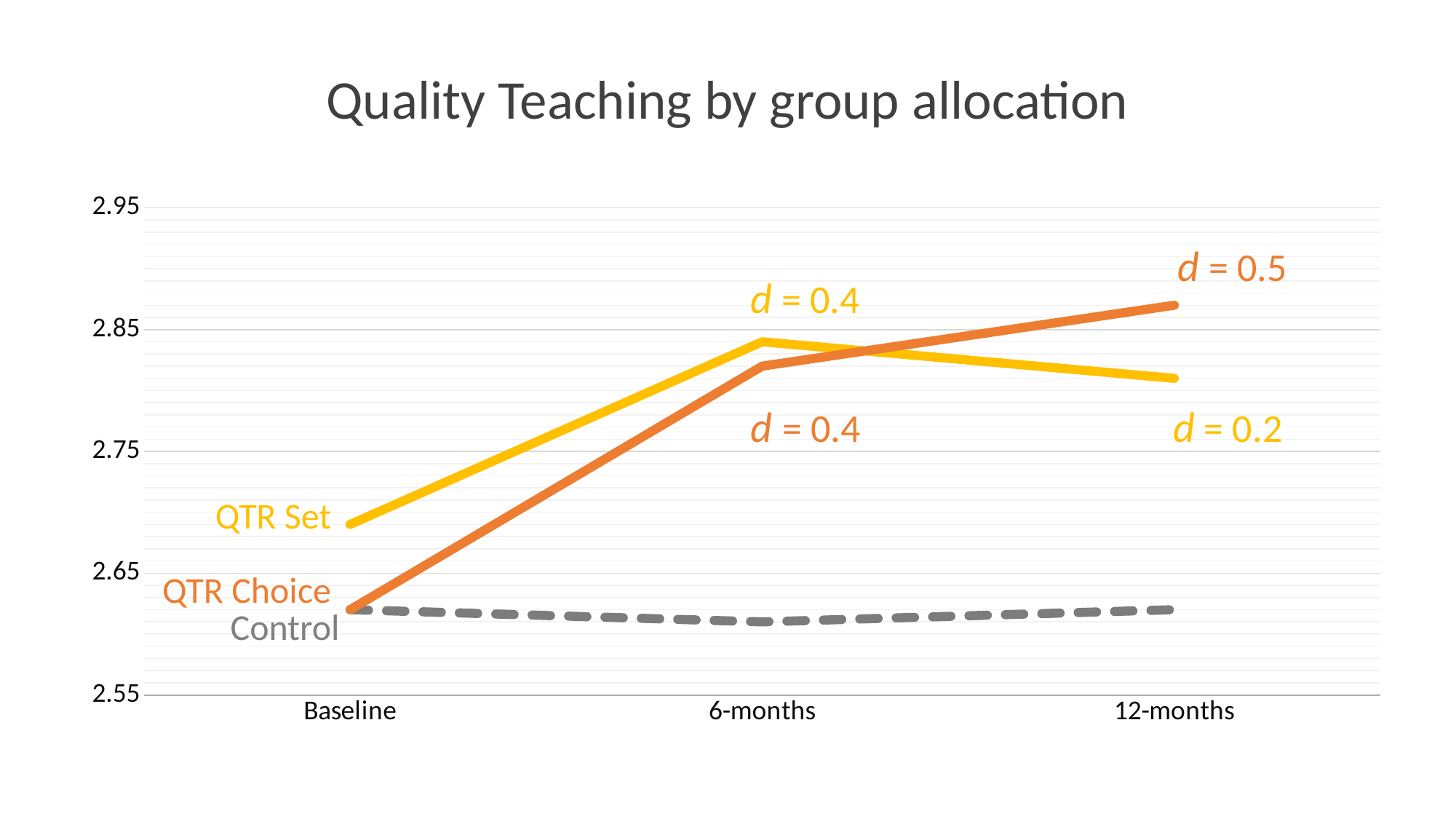
Is the value for QTR Set at Baseline greater or less than 2.75? less What is the title of the chart? Quality Teaching by group allocation Is the value for Control at 6-months greater or less than 2.65? less What effect size (d) is labelled for QTR Set at 12-months? d = 0.2 At 12-months, which is higher: QTR Choice or QTR Set? QTR Choice How many groups are plotted on the chart? 3 How many time points are shown on the x axis? 3 Does the QTR Set line rise or fall between 6-months and 12-months? fall Is the value for QTR Choice at 12-months greater or less than 2.85? greater Which group has the lowest value at 12-months? Control What kind of chart is shown on the slide? line chart At 6-months, which is higher: QTR Set or QTR Choice? QTR Set